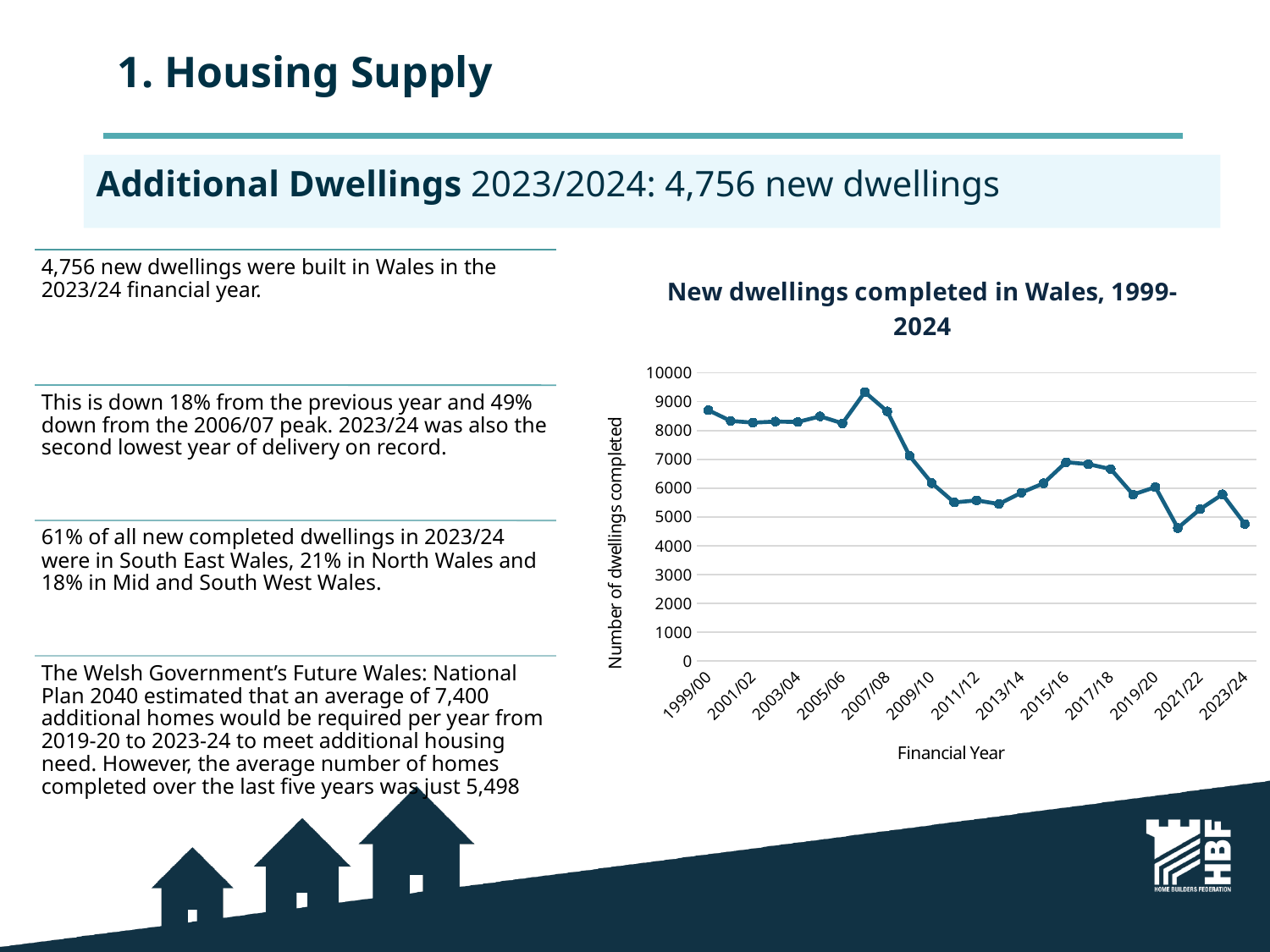
Is the value for 2011/12 greater or less than 6000? less What kind of chart is shown on the slide? line chart Which is larger, the value for 1999/00 or the value for 2023/24? 1999/00 What is the label on the vertical axis of the chart? Number of dwellings completed How many data points are plotted on the line in the chart? 25 Is the value for 1999/00 greater or less than 8000? greater Is the highest point on the line greater or less than 9000? greater Overall, do the values rise or fall from 1999/00 to 2023/24? fall What is the title of the chart? New dwellings completed in Wales, 1999-2024